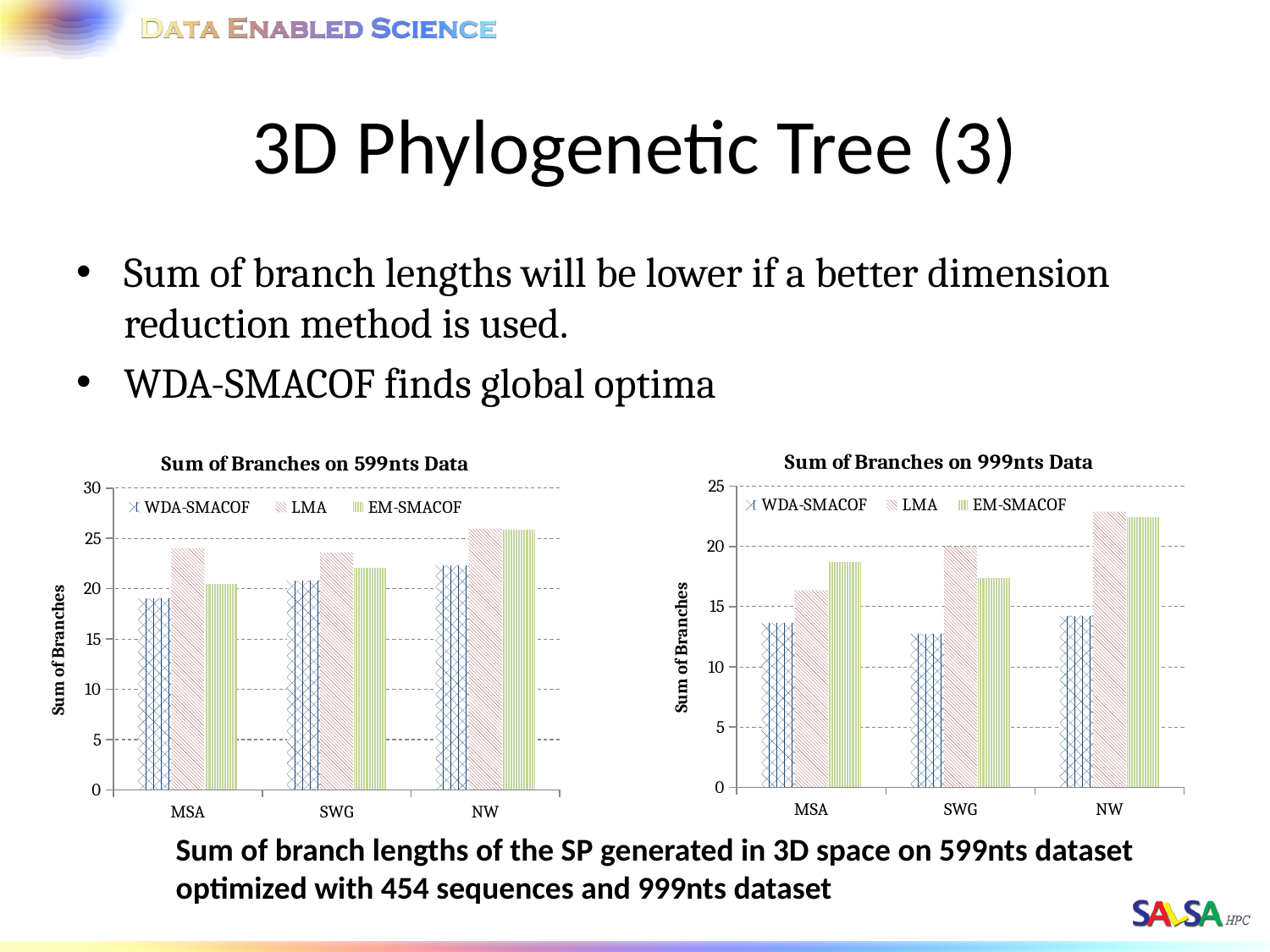
What is the title of the chart on the right side of the slide? Sum of Branches on 999nts Data In the 'Sum of Branches on 999nts Data' chart, which series has the lowest value for SWG? WDA-SMACOF In the 'Sum of Branches on 599nts Data' chart, for MSA, which is larger: LMA or WDA-SMACOF? LMA In the 'Sum of Branches on 999nts Data' chart, how many categories are shown on the x axis? 3 In the 'Sum of Branches on 599nts Data' chart, is the LMA value for MSA greater or less than 20? greater In the 'Sum of Branches on 999nts Data' chart, for MSA, which is larger: EM-SMACOF or LMA? EM-SMACOF What kind of chart is the 'Sum of Branches on 599nts Data' chart? bar chart In the 'Sum of Branches on 599nts Data' chart, is the WDA-SMACOF value for NW greater or less than 20? greater In the 'Sum of Branches on 599nts Data' chart, how many series does the legend list? 3 In the 'Sum of Branches on 999nts Data' chart, which category has the highest LMA value? NW In the 'Sum of Branches on 999nts Data' chart, is the WDA-SMACOF value for SWG greater or less than 15? less